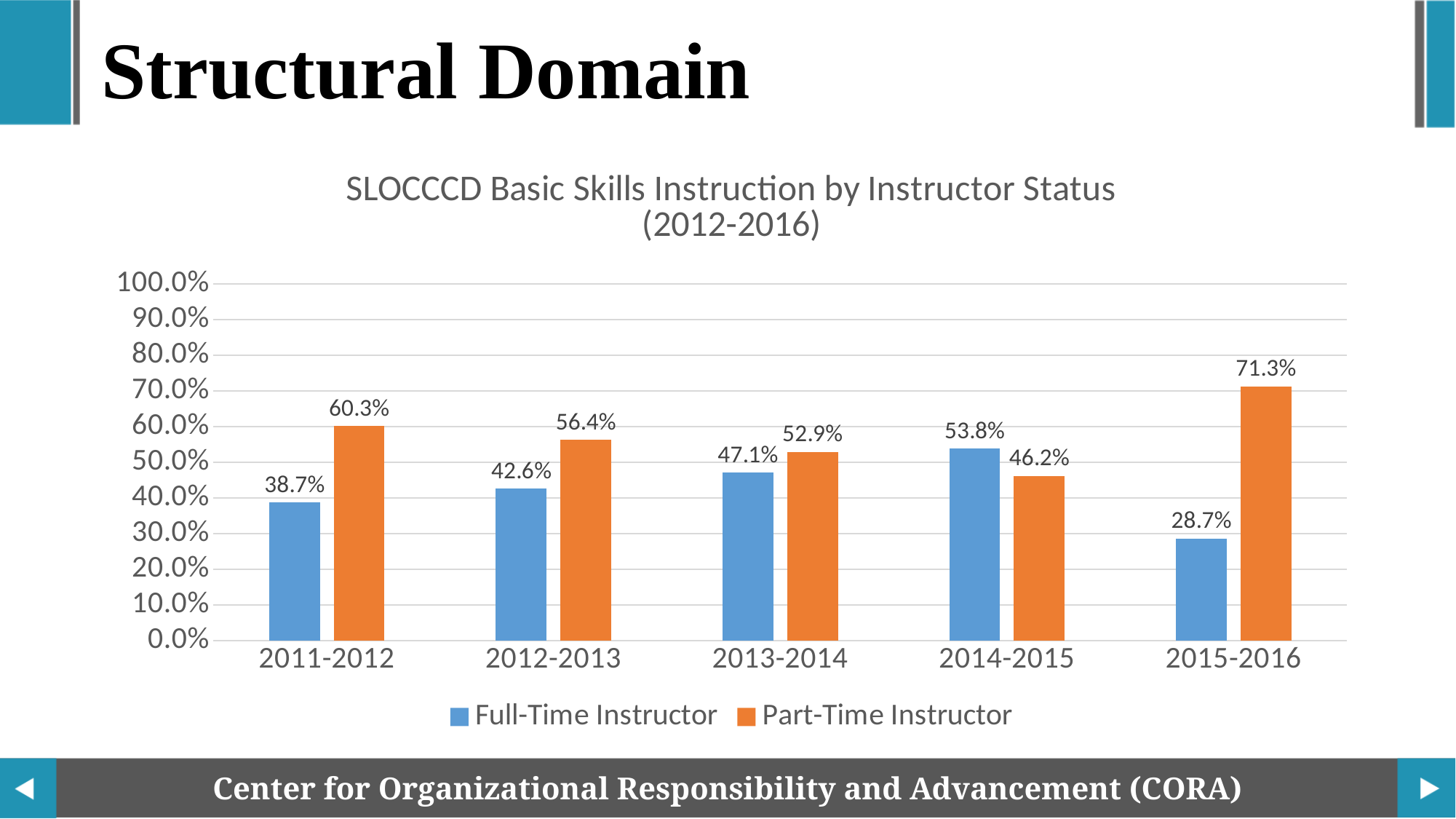
What is the Part-Time Instructor value for 2015-2016? 71.3% How many academic years are shown on the x axis? 5 In which year is the Full-Time Instructor value lowest? 2015-2016 How many series does the legend list? 2 What is the Part-Time Instructor value for 2013-2014? 52.9% In which year is the Part-Time Instructor value lowest? 2014-2015 What is the difference between the Part-Time and Full-Time Instructor values in 2015-2016? 42.6% In which year is the Full-Time Instructor value highest? 2014-2015 What kind of chart is shown on the slide? Bar chart What colour represents the Part-Time Instructor series? Orange Which is larger in 2014-2015, the Full-Time Instructor value or the Part-Time Instructor value? Full-Time Instructor What is the Full-Time Instructor value for 2011-2012? 38.7%